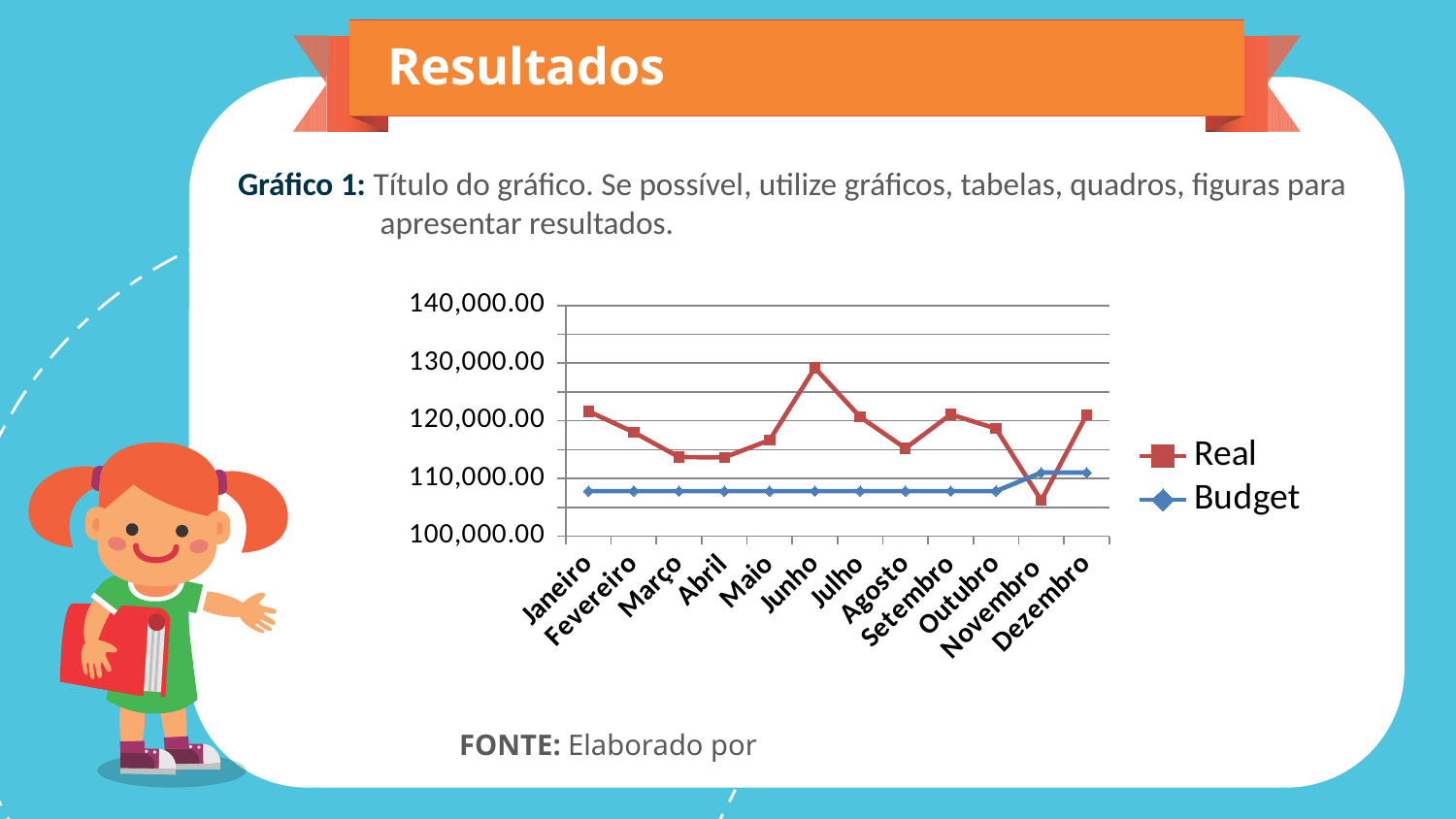
In which month does the Real series reach its lowest value? Novembro Is the Budget value for Janeiro greater or less than 110,000.00? less For the Real series, which month has the larger value, Janeiro or Março? Janeiro How many series does the chart legend list? 2 What are the two entries listed in the chart legend? Real and Budget Is the Real value for Junho greater or less than 120,000.00? greater In Junho, which series has the larger value, Real or Budget? Real What kind of chart is shown on the slide? line chart In which month does the Real series reach its highest value? Junho Does the Real series rise or fall from Janeiro to Março? fall How many months are plotted along the x axis of the chart? 12 Is the Real value for Novembro greater or less than 110,000.00? less